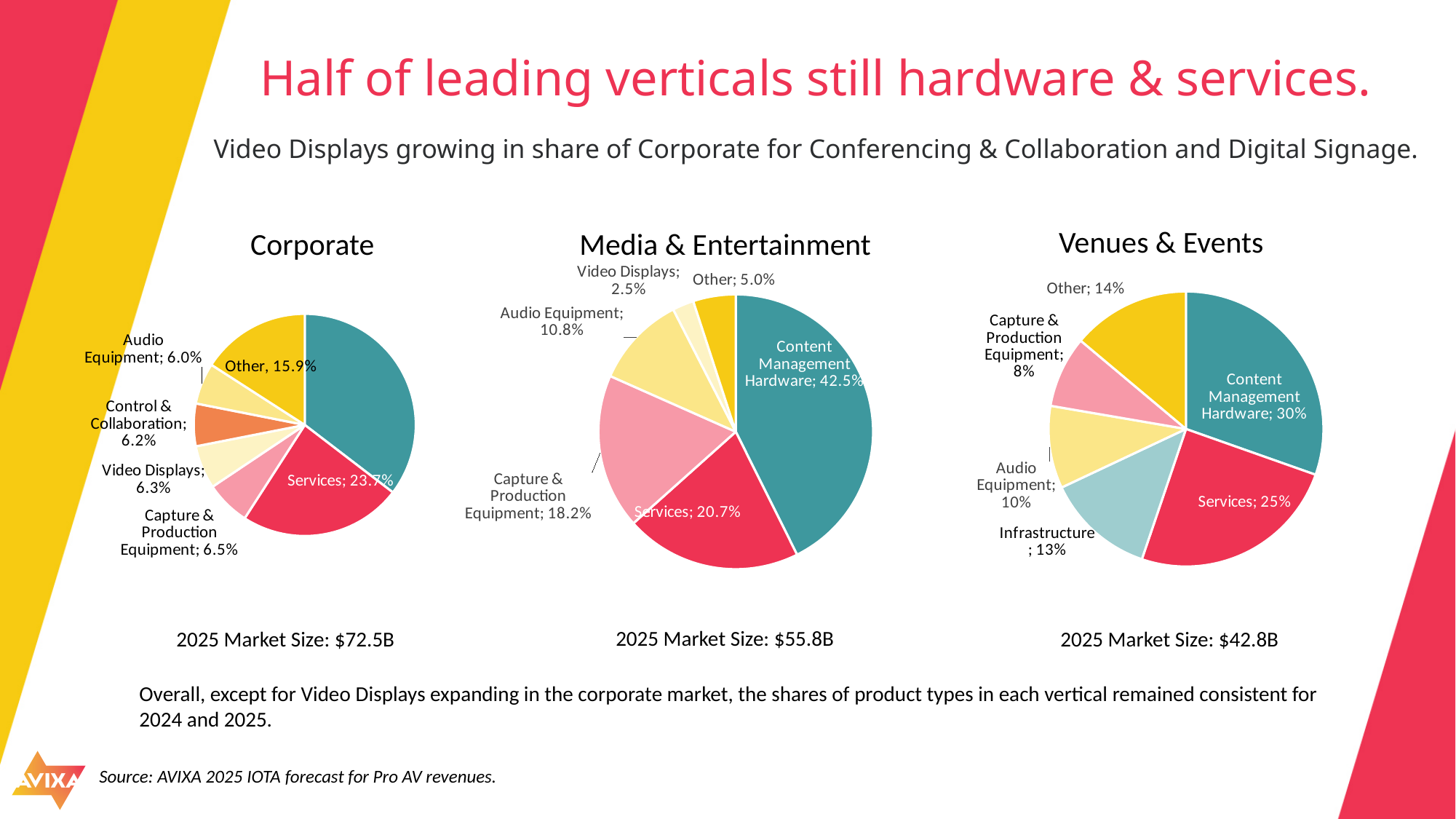
In the Corporate pie chart, what share does Other have? 15.9% In the Media & Entertainment pie chart, what share does Content Management Hardware have? 42.5% In the Media & Entertainment pie chart, which category has the smallest share? Video Displays How many slices does the Media & Entertainment pie chart have? 6 What type of chart is used for the Corporate, Media & Entertainment and Venues & Events data? Pie chart In the Venues & Events pie chart, how many percentage points larger is Content Management Hardware than Services? 5% In the Media & Entertainment pie chart, which is larger: Services or Capture & Production Equipment? Services In the Venues & Events pie chart, what share does Services have? 25% In the Media & Entertainment pie chart, how many percentage points larger is Content Management Hardware than Services? 21.8% In the Venues & Events pie chart, which category has the smallest share? Capture & Production Equipment In the Corporate pie chart, what share does Video Displays have? 6.3% In the Media & Entertainment pie chart, which category has the largest share? Content Management Hardware